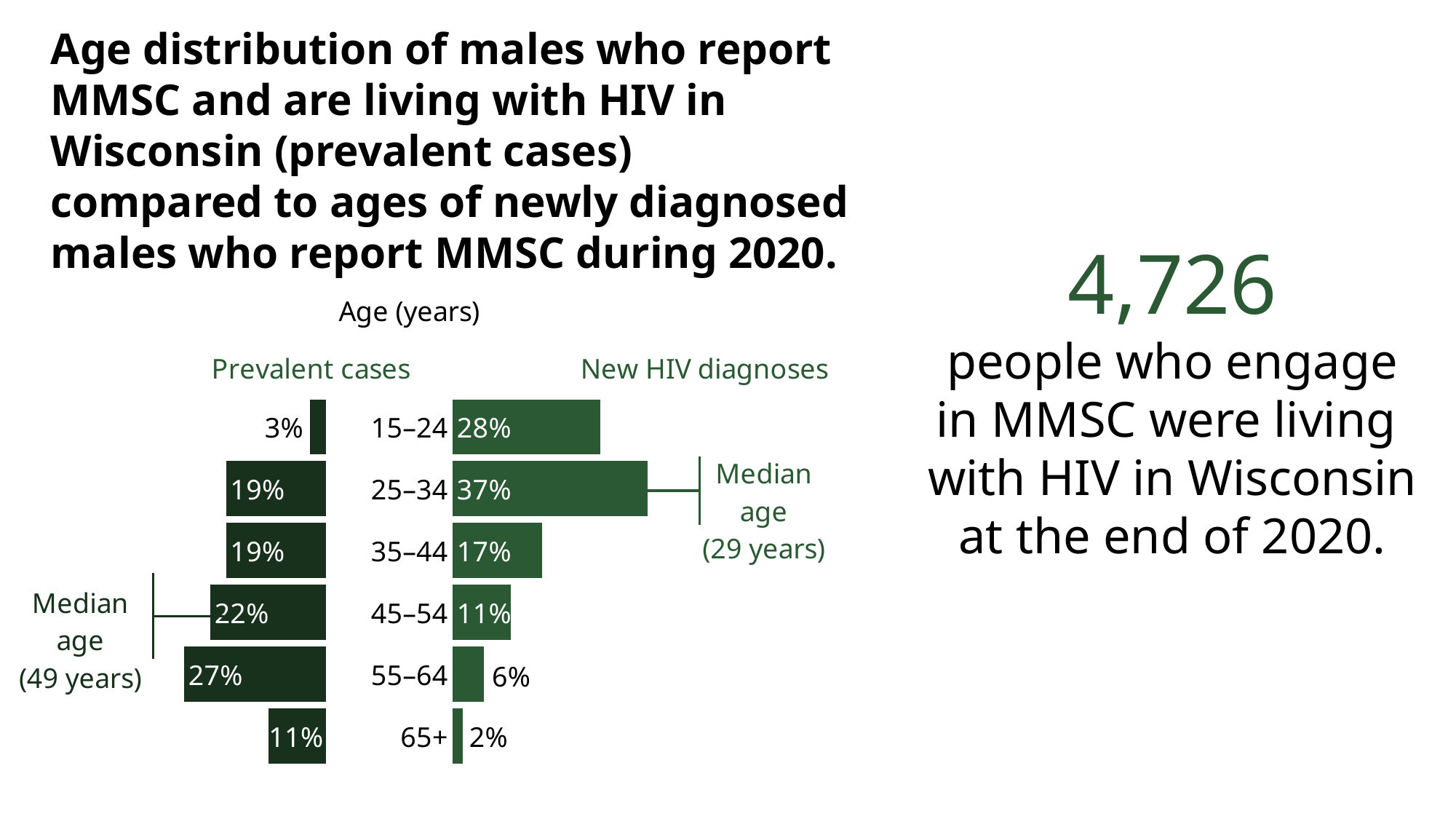
What percentage of new HIV diagnoses are in the 25–34 age group? 37% What is the median age of the prevalent cases shown in the chart? 49 years What percentage of prevalent cases are in the 45–54 age group? 22% Which age group has the highest share of prevalent cases? 55–64 Which age group has the highest share of new HIV diagnoses? 25–34 How many age groups are shown in the chart? 6 Which age group has the lowest share of new HIV diagnoses? 65+ Which age group has the lowest share of prevalent cases? 15–24 What is the difference between the new HIV diagnoses share and the prevalent cases share for the 15–24 age group? 25% What type of chart is shown on the slide? Bar chart What percentage of prevalent cases are in the 15–24 age group? 3% For the 55–64 age group, which is larger: the share of prevalent cases or the share of new HIV diagnoses? Prevalent cases